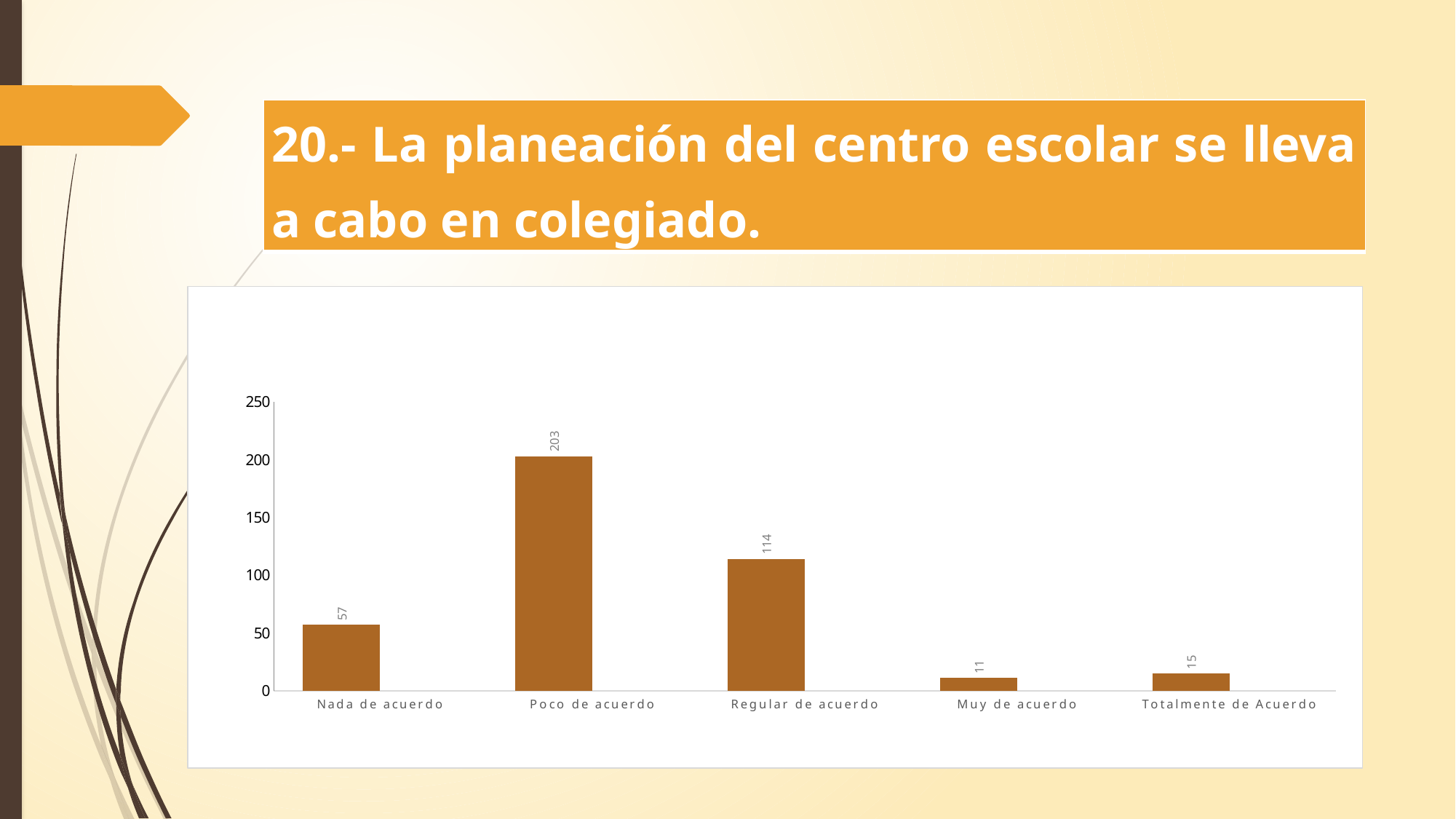
What is the difference between the values for "Poco de acuerdo" and "Regular de acuerdo"? 89 Which category has the highest value? Poco de acuerdo What is the value for "Poco de acuerdo"? 203 Which category has the lowest value? Muy de acuerdo What is the value for "Totalmente de Acuerdo"? 15 What kind of chart is shown on the slide? bar chart What is the title of the slide above the chart? 20.- La planeación del centro escolar se lleva a cabo en colegiado. What is the value for "Muy de acuerdo"? 11 What is the value for "Nada de acuerdo"? 57 Is the value for "Regular de acuerdo" greater or less than 100? greater How many categories are shown on the x axis? 5 Which is larger, the value for "Nada de acuerdo" or the value for "Regular de acuerdo"? Regular de acuerdo